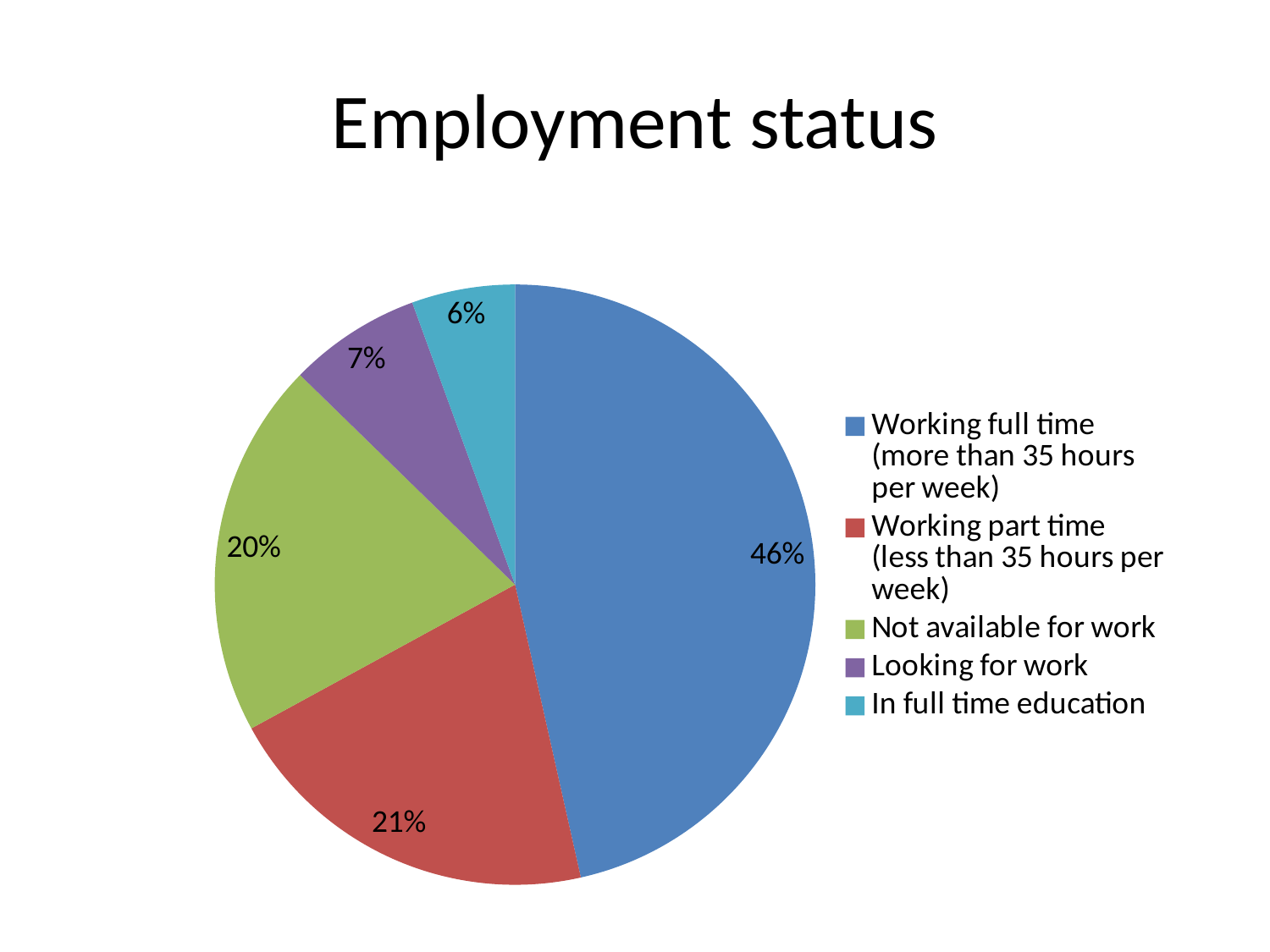
How many categories does the pie chart show? 5 What kind of chart is shown on the slide? Pie chart What is the title of the chart? Employment status Which is larger: the share for 'Working part time (less than 35 hours per week)' or 'Not available for work'? Working part time (less than 35 hours per week) What is the difference in percentage points between 'Working full time' and 'Working part time'? 25 What percentage is shown for 'Not available for work'? 20% What percentage is shown for 'In full time education'? 6% What colour is the slice for 'Looking for work'? Purple What share of the pie is 'Working full time (more than 35 hours per week)'? 46% Which category has the largest slice of the pie? Working full time (more than 35 hours per week) Which category has the smallest slice of the pie? In full time education What percentage is shown for 'Looking for work'? 7%